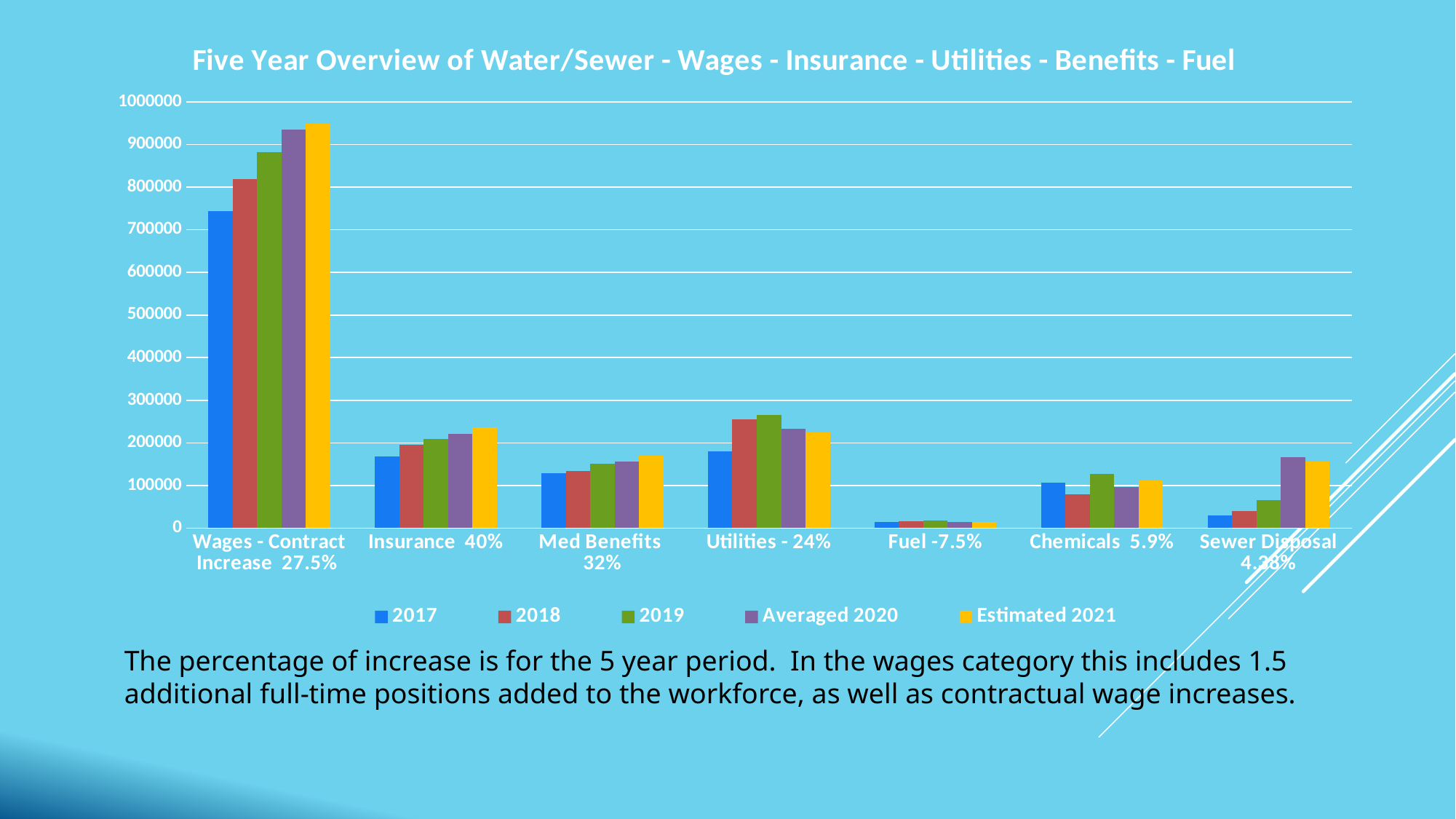
How many categories are shown along the x axis? 7 Which category has the highest Estimated 2021 value? Wages - Contract Increase 27.5% Is the 2017 value for Utilities - 24% greater or less than 200000? less For Wages - Contract Increase 27.5%, do the values rise or fall from 2017 to Estimated 2021? rise Is the Estimated 2021 value for Insurance 40% greater or less than 200000? greater For Sewer Disposal 4.28%, which is larger: the 2017 value or the Averaged 2020 value? Averaged 2020 Which category has the lowest values across all series? Fuel -7.5% What is the title of the chart? Five Year Overview of Water/Sewer - Wages - Insurance - Utilities - Benefits - Fuel What kind of chart is shown on the slide? bar chart Which is larger for 2019: Utilities - 24% or Chemicals 5.9%? Utilities - 24% How many series does the legend list? 5 Is the 2017 value for Wages - Contract Increase 27.5% greater or less than 700000? greater